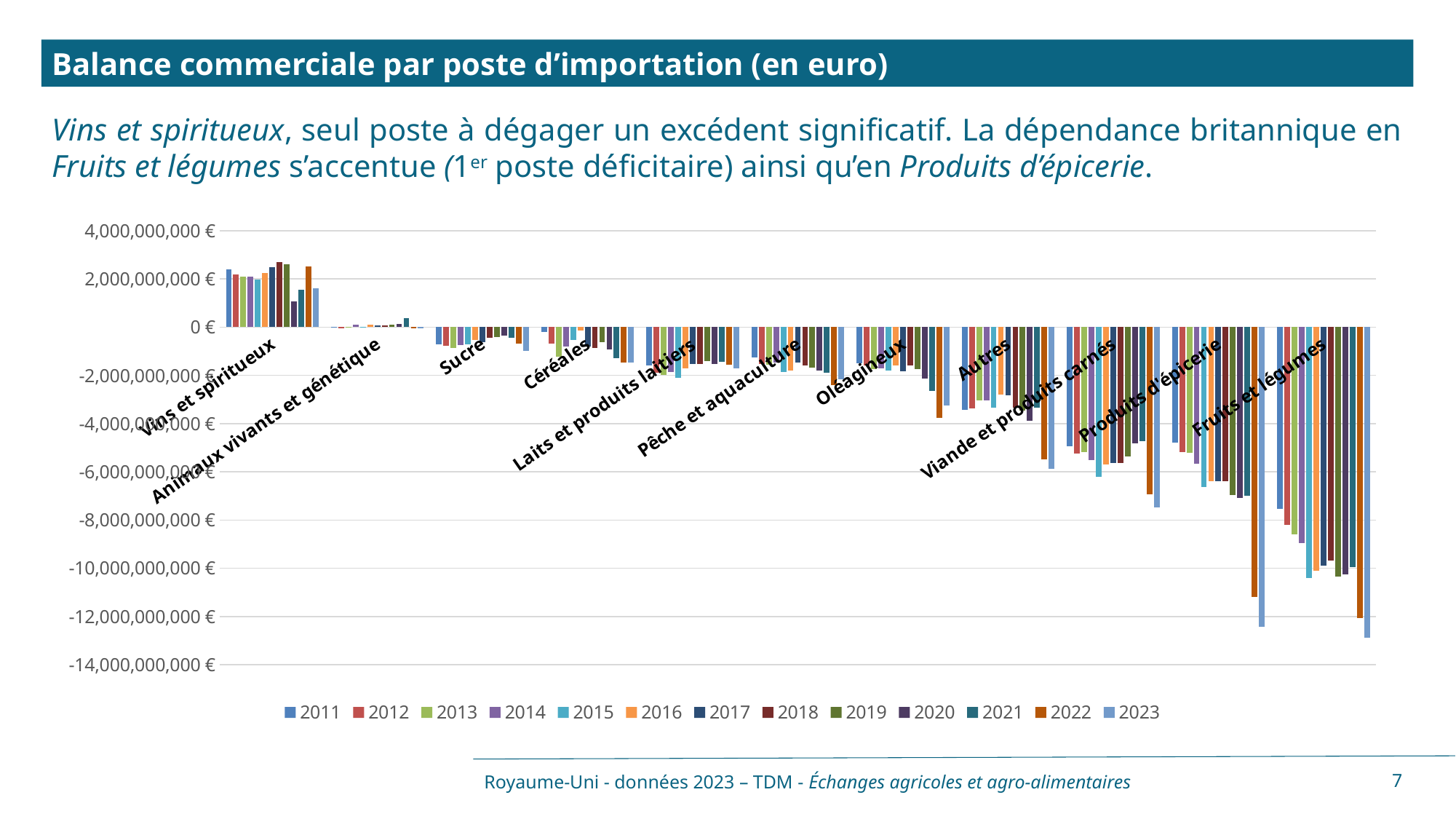
Is the 2011 value for Vins et spiritueux greater or less than 2,000,000,000 €? greater Is the 2023 value for Fruits et légumes greater or less than -12,000,000,000 €? less How many import categories are shown on the x axis of the chart? 11 For Vins et spiritueux, which year has the higher value: 2018 or 2020? 2018 What kind of chart is shown on the slide? bar chart What is the title of the chart on the slide? Balance commerciale par poste d'importation (en euro) For 2023, which category has the lower value: Fruits et légumes or Produits d'épicerie? Fruits et légumes Which category is the only one with clearly positive (surplus) values in the chart? Vins et spiritueux Which category has the lowest (most negative) value in the chart? Fruits et légumes How many series (years) does the chart legend list? 13 Is the 2023 value for Produits d'épicerie greater or less than -6,000,000,000 €? less